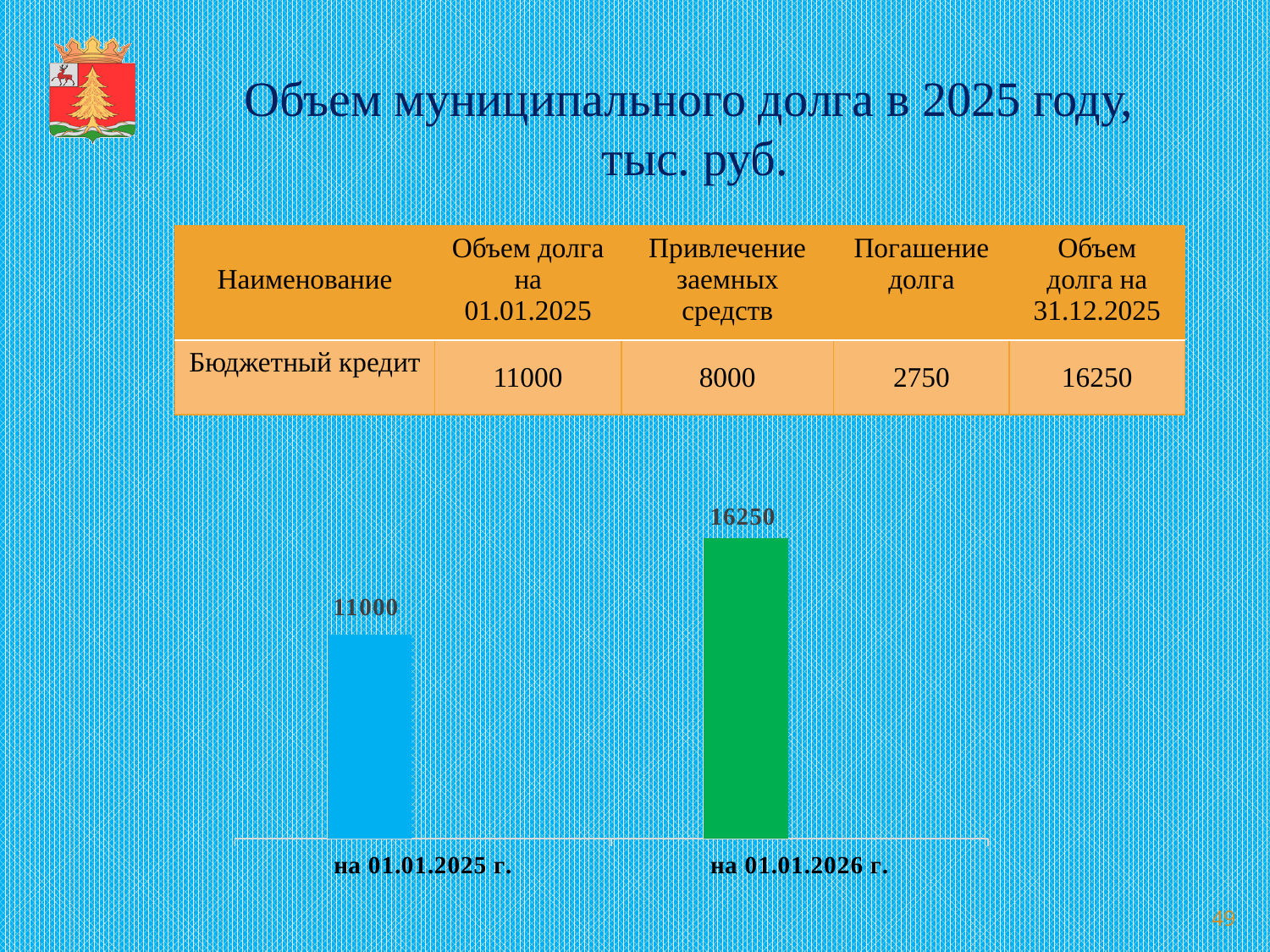
What colour is the bar for "на 01.01.2026 г."? green What colour is the bar for "на 01.01.2025 г."? blue What is the difference between the values for "на 01.01.2026 г." and "на 01.01.2025 г."? 5250 Which category has the highest bar? на 01.01.2026 г. Which is larger: the value for "на 01.01.2025 г." or the value for "на 01.01.2026 г."? на 01.01.2026 г. What is the value of the bar labelled "на 01.01.2025 г."? 11000 What kind of chart is shown on the slide? bar chart What is the value of the bar labelled "на 01.01.2026 г."? 16250 How many bars are shown in the chart? 2 Do the values rise or fall from "на 01.01.2025 г." to "на 01.01.2026 г."? rise Which category has the lowest bar? на 01.01.2025 г.